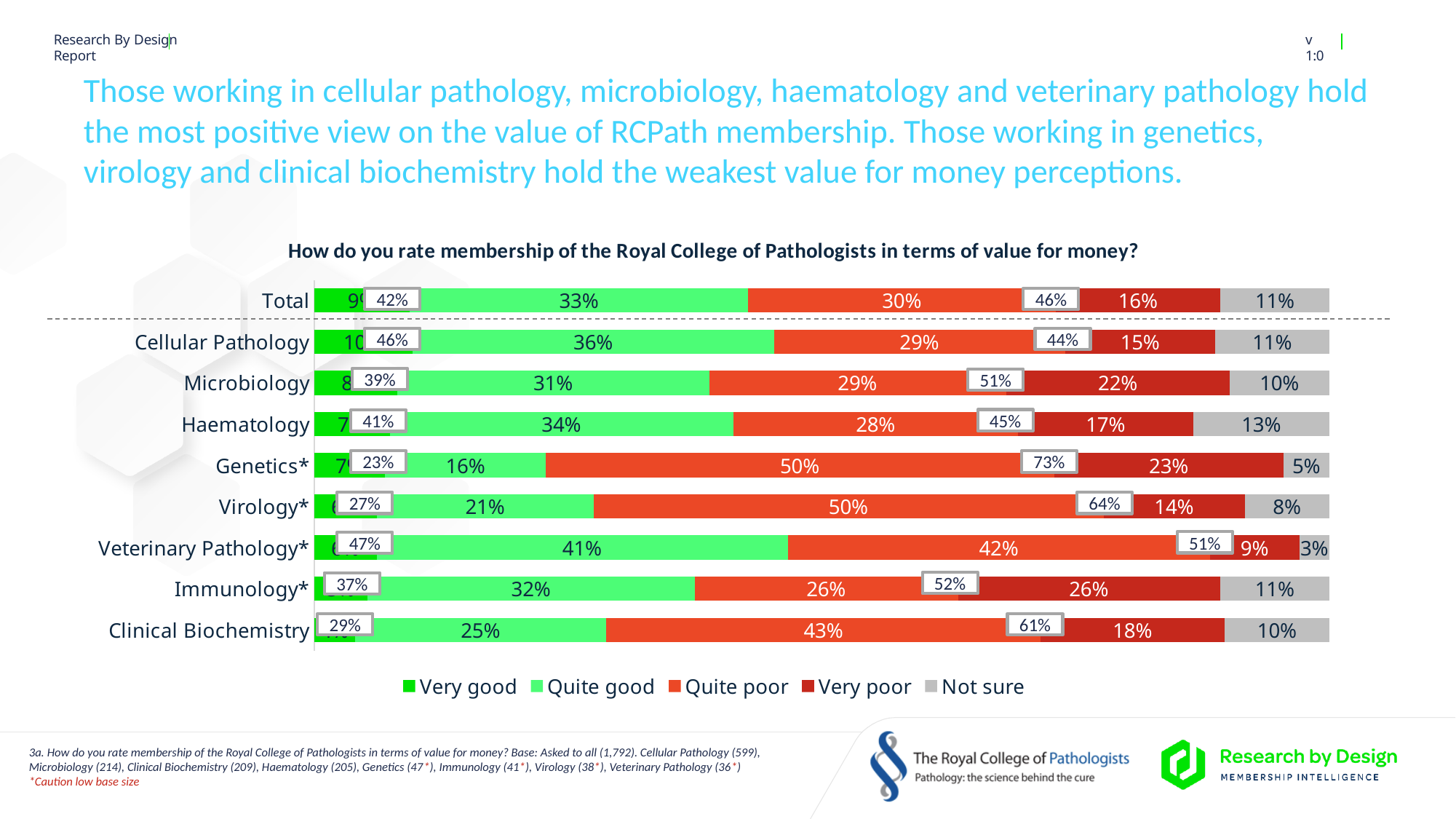
Which category has the highest 'Quite good' value? Veterinary Pathology Which category has the highest 'Very poor' value? Immunology How many series does the chart legend list? 5 What is the title of the chart? How do you rate membership of the Royal College of Pathologists in terms of value for money? Which has the larger 'Very poor' value, Immunology or Virology? Immunology Which category has the lowest 'Not sure' value? Veterinary Pathology What is the 'Quite poor' value for Genetics? 50% What kind of chart is shown on the slide? Stacked bar chart What is the 'Not sure' value for Haematology? 13% What is the 'Quite good' value for Clinical Biochemistry? 25% What is the difference in percentage points between the 'Very poor' values for Microbiology and Cellular Pathology? 7 How many categories (rows) are plotted in the chart, including Total? 9